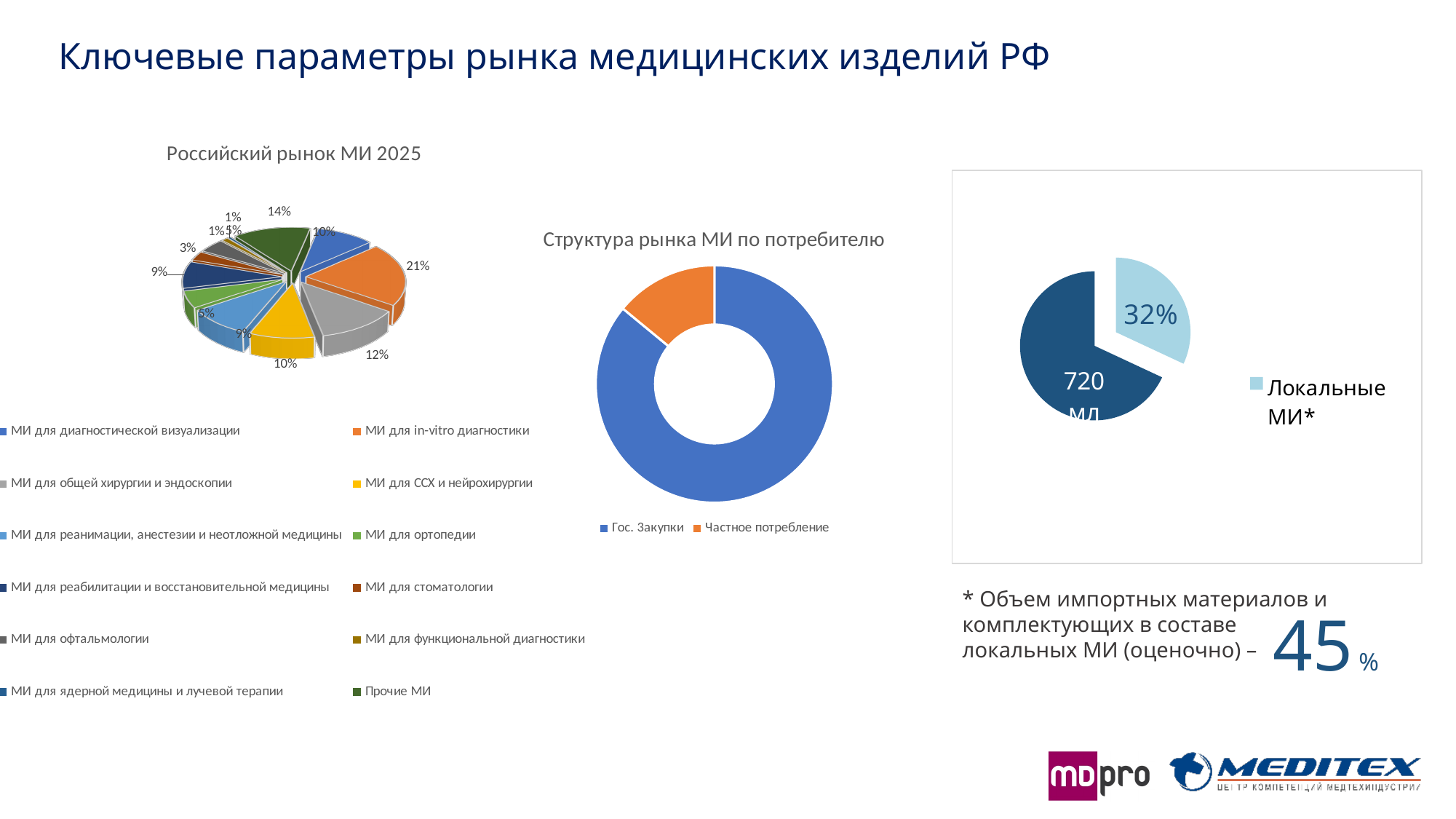
In the chart titled "Российский рынок МИ 2025", what share is shown for МИ для стоматологии? 3% In the chart titled "Российский рынок МИ 2025", what share is shown for МИ для in-vitro диагностики? 21% In the chart titled "Структура рынка МИ по потребителю", how many categories does the legend list? 2 In the chart titled "Российский рынок МИ 2025", what share is shown for МИ для общей хирургии и эндоскопии? 12% In the chart titled "Структура рынка МИ по потребителю", what colour represents Частное потребление? Orange In the chart titled "Российский рынок МИ 2025", what is the difference between the shares of МИ для in-vitro диагностики and МИ для общей хирургии и эндоскопии? 9% In the chart titled "Российский рынок МИ 2025", which category has the largest share? МИ для in-vitro диагностики In the pie chart on the right of the slide, what share is shown for Локальные МИ*? 32% What kind of chart is "Российский рынок МИ 2025"? Pie chart In the chart titled "Российский рынок МИ 2025", how many categories does the legend list? 12 In the chart titled "Российский рынок МИ 2025", what share is shown for Прочие МИ? 14% In the chart titled "Структура рынка МИ по потребителю", which is larger: Гос. Закупки or Частное потребление? Гос. Закупки